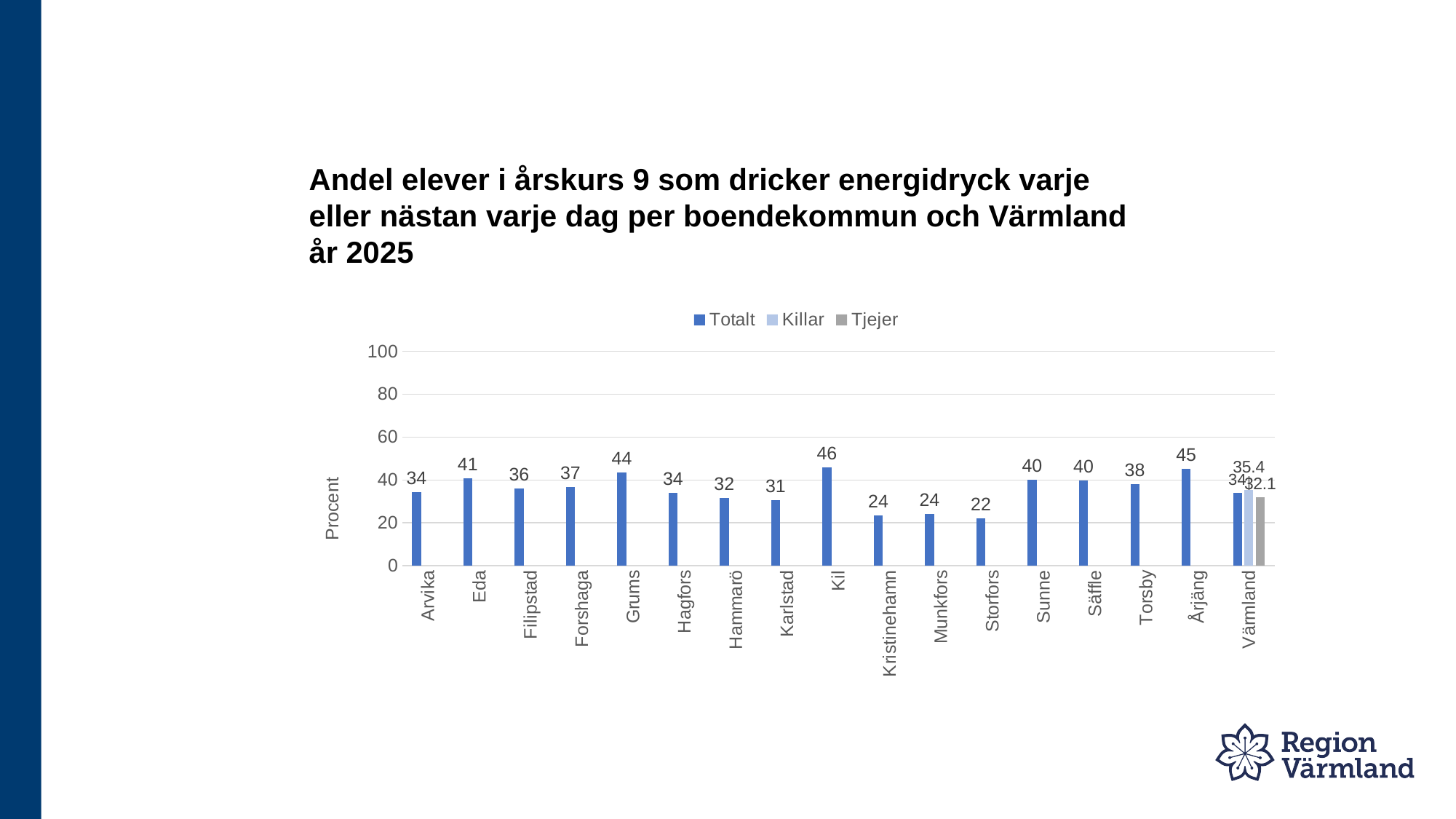
How many categories are shown on the x axis? 17 What is the difference between the Totalt values for Grums and Hagfors? 10 How many series does the legend list? 3 What is the Killar value for Värmland? 35.4 Which category has the highest Totalt value? Kil What is the Totalt value for Karlstad? 31 Which has a larger Totalt value, Eda or Torsby? Eda What kind of chart is shown on the slide? Bar chart Which category has the lowest Totalt value? Storfors What is the Totalt value for Kil? 46 What is the Tjejer value for Värmland? 32.1 What is the label of the y axis? Procent